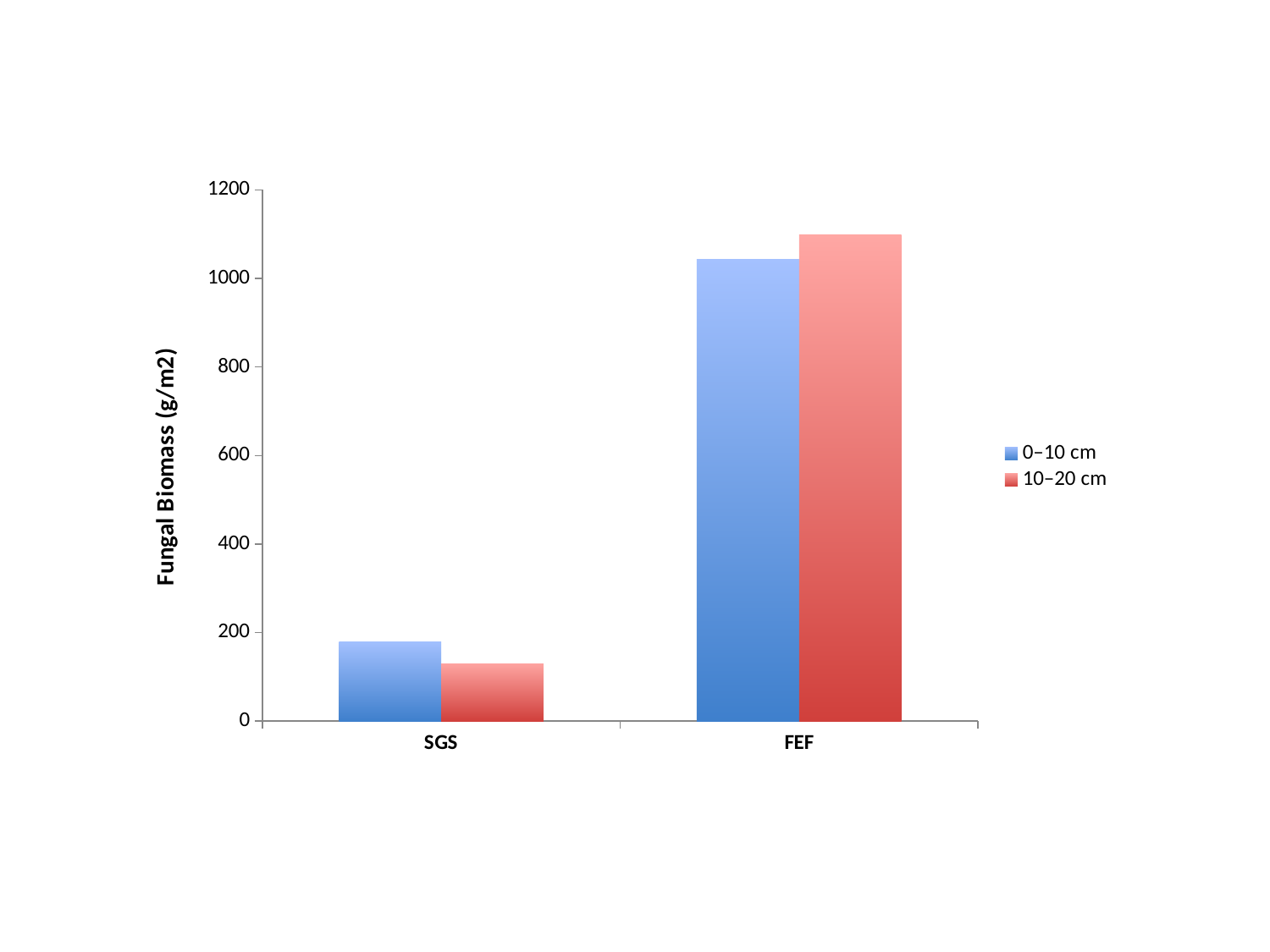
Which colour represents the 10–20 cm series in the legend? red How many categories are shown on the x axis? 2 For SGS, which series has the larger value, 0–10 cm or 10–20 cm? 0–10 cm Is the value for FEF in the 0–10 cm series greater or less than 1000? greater How many series does the legend list? 2 Is the value for SGS in the 0–10 cm series greater or less than 200? less Which category has the lowest fungal biomass for the 10–20 cm series? SGS Which category has the highest fungal biomass for the 0–10 cm series? FEF For FEF, which series has the larger value, 0–10 cm or 10–20 cm? 10–20 cm Is the value for SGS in the 10–20 cm series greater or less than 200? less What is the label of the y axis? Fungal Biomass (g/m2) What kind of chart is shown on the slide? bar chart